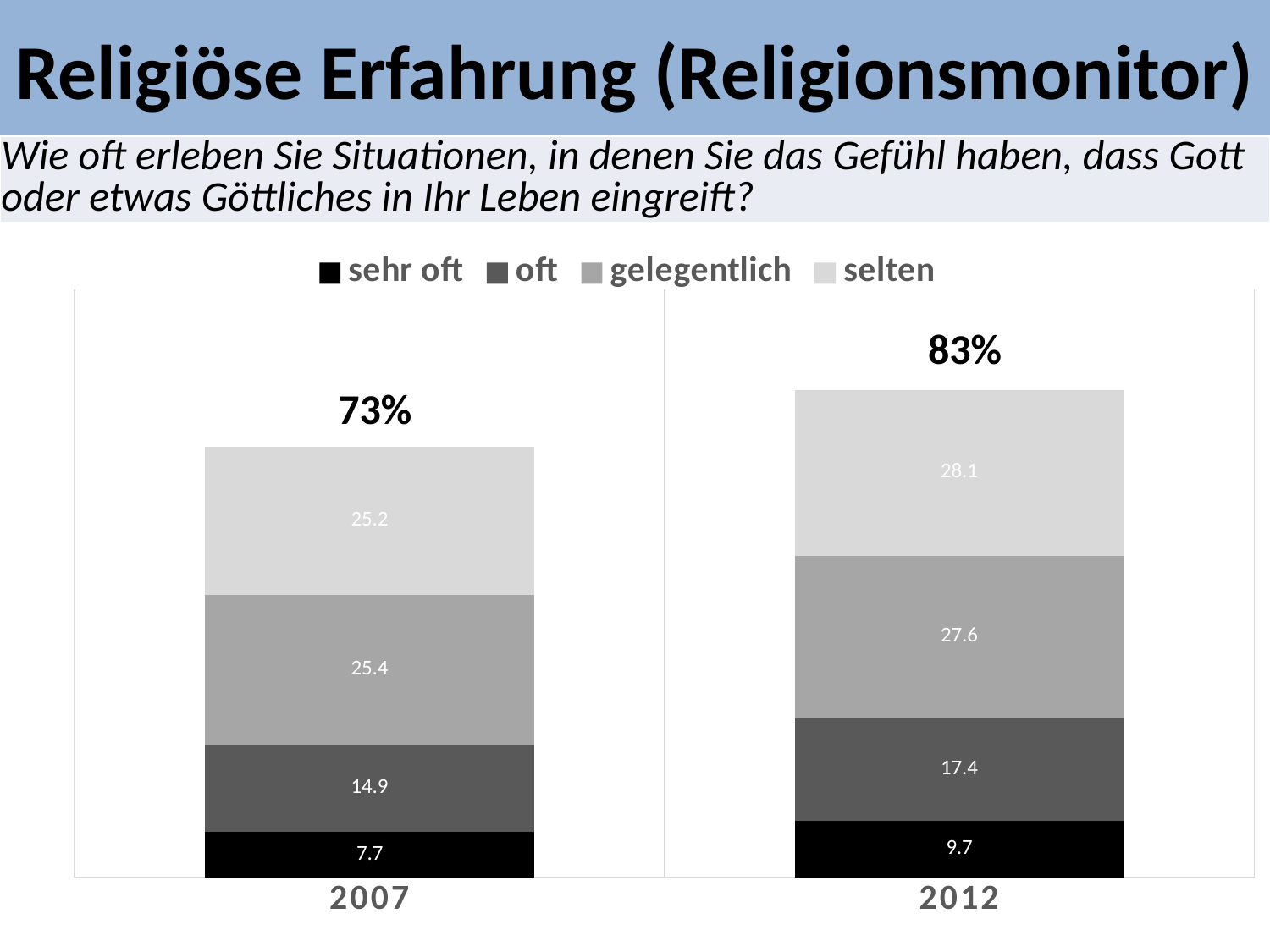
What total percentage is printed above the 2012 bar? 83% What total percentage is printed above the 2007 bar? 73% Which year has the larger value for "sehr oft", 2007 or 2012? 2012 What is the value for "selten" in 2012? 28.1 How many series does the legend list? 4 What is the difference between the "oft" values for 2012 and 2007? 2.5 What is the value for "oft" in 2012? 17.4 What is the value for "sehr oft" in 2007? 7.7 What is the value for "gelegentlich" in 2007? 25.4 What kind of chart is shown on the slide? stacked bar chart Which series is listed first in the legend? sehr oft How many categories are shown on the x axis? 2